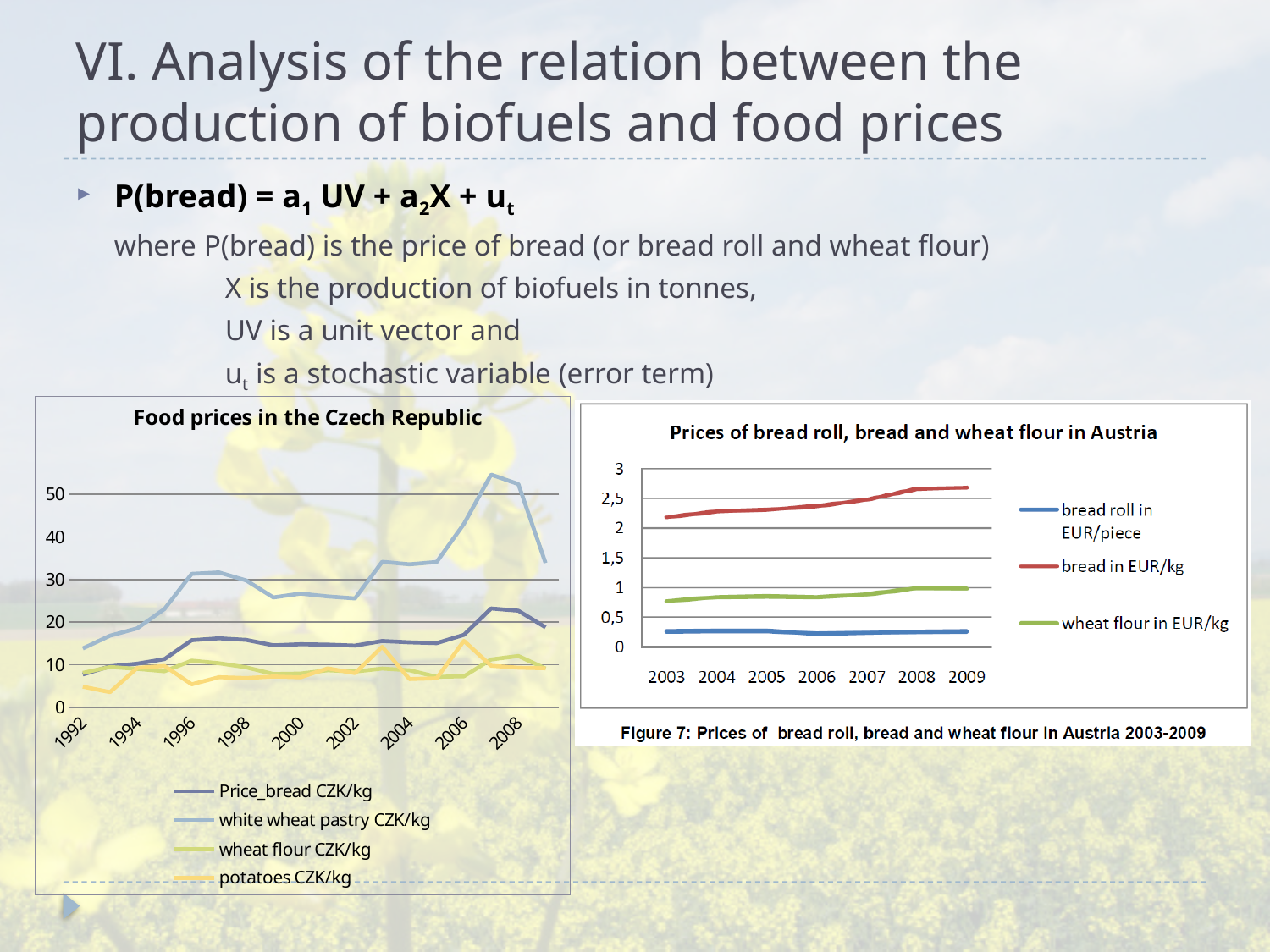
How many series does the legend of the 'Food prices in the Czech Republic' chart list? 4 In the 'Food prices in the Czech Republic' chart, is the peak value of white wheat pastry CZK/kg greater or less than 50? greater In the 'Food prices in the Czech Republic' chart, which series reaches the highest value? white wheat pastry CZK/kg In the 'Food prices in the Czech Republic' chart, is the value for Price_bread CZK/kg in 1992 greater or less than 10? less How many years are shown on the x axis of the 'Prices of bread roll, bread and wheat flour in Austria' chart? 7 In the 'Prices of bread roll, bread and wheat flour in Austria' chart, is the value for bread in EUR/kg in 2009 greater or less than 2.5? greater What is the title of the chart on the left of the slide? Food prices in the Czech Republic What kind of chart is the 'Prices of bread roll, bread and wheat flour in Austria' chart? line chart In the 'Prices of bread roll, bread and wheat flour in Austria' chart, does the bread in EUR/kg line rise or fall from 2003 to 2009? rise In the 'Prices of bread roll, bread and wheat flour in Austria' chart, which is larger in 2009: bread in EUR/kg or bread roll in EUR/piece? bread in EUR/kg How many series does the legend of the 'Prices of bread roll, bread and wheat flour in Austria' chart list? 3